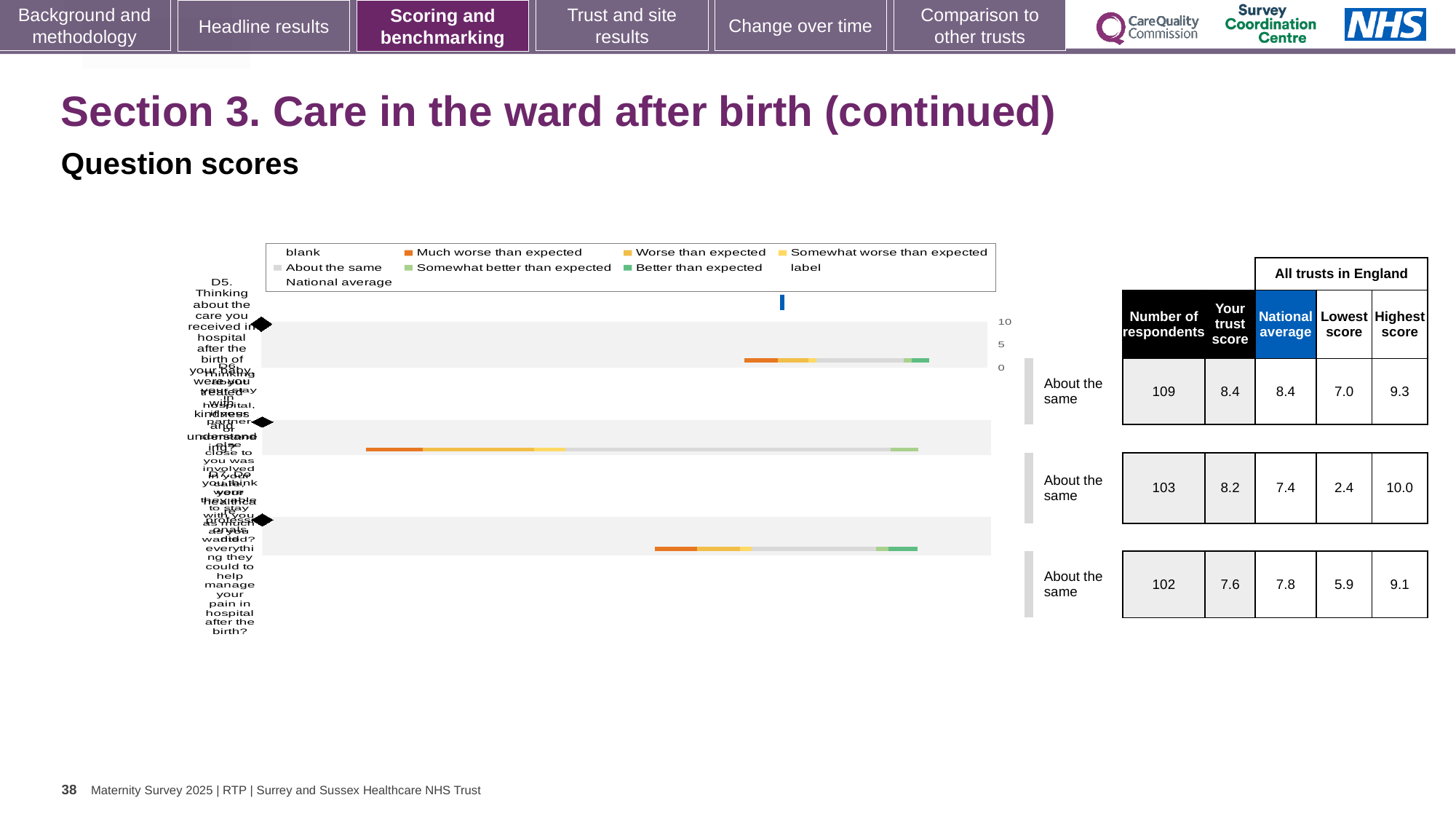
In the table beside the chart, is the trust score for the second row (8.2) larger or smaller than its national average (7.4)? larger How many entries does the chart legend list? 9 In the table beside the chart, which row has the lowest 'Lowest score' value? D6 (2.4) What is the first legend entry listed in the chart legend? blank What benchmark category is shown next to the third bar (D7)? About the same What kind of chart is shown on the slide? bar chart What benchmark category is shown next to the first bar (D5)? About the same In the table beside the chart, what is the number of respondents for the first row (D5)? 109 In the table beside the chart, what is the highest score for the third row (D7)? 9.1 In the table beside the chart, what is the trust score for the second row (D6)? 8.2 Which legend entry is shown in the darkest orange colour? Much worse than expected How many question rows (bars) are plotted in the chart? 3